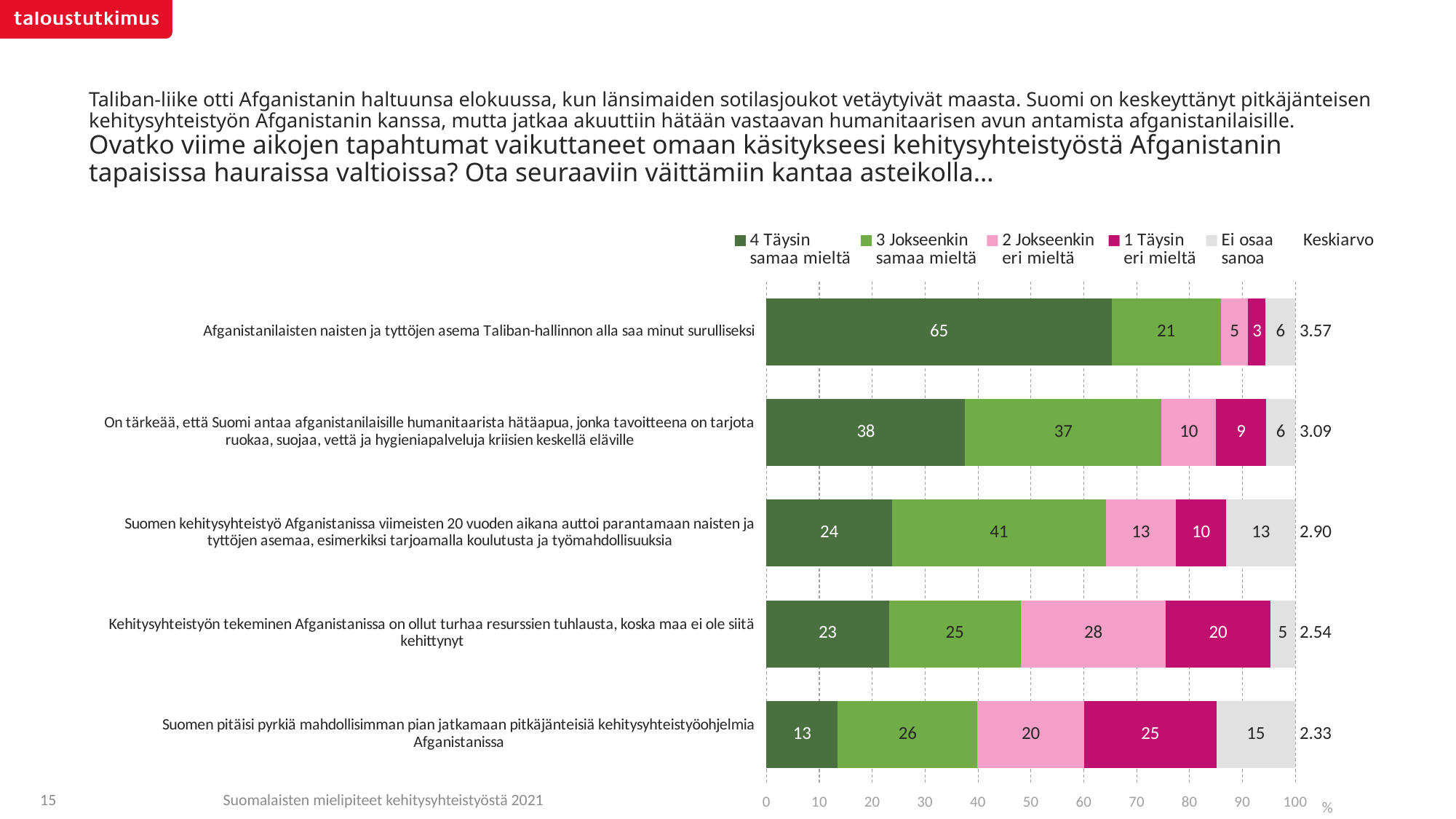
Which series is shown in dark green in the chart? 4 Täysin samaa mieltä What is the Keskiarvo value for the statement 'Suomen pitäisi pyrkiä mahdollisimman pian jatkamaan pitkäjänteisiä kehitysyhteistyöohjelmia Afganistanissa'? 2.33 What percentage answered '1 Täysin eri mieltä' to the statement 'Kehitysyhteistyön tekeminen Afganistanissa on ollut turhaa resurssien tuhlausta, koska maa ei ole siitä kehittynyt'? 20 How many series does the legend list? 5 How many statements (categories) are plotted in the chart? 5 Which is larger: the 'Ei osaa sanoa' share for 'Suomen kehitysyhteistyö Afganistanissa viimeisten 20 vuoden aikana auttoi...' or for 'Suomen pitäisi pyrkiä mahdollisimman pian jatkamaan...'? Suomen pitäisi pyrkiä mahdollisimman pian jatkamaan pitkäjänteisiä kehitysyhteistyöohjelmia Afganistanissa What is the difference between the '3 Jokseenkin samaa mieltä' share for 'Suomen kehitysyhteistyö Afganistanissa viimeisten 20 vuoden aikana auttoi parantamaan naisten ja tyttöjen asemaa...' and for 'Afganistanilaisten naisten ja tyttöjen asema Taliban-hallinnon alla saa minut surulliseksi'? 20 What kind of chart is shown on the slide? stacked bar chart Which statement has the highest Keskiarvo value? Afganistanilaisten naisten ja tyttöjen asema Taliban-hallinnon alla saa minut surulliseksi What is the combined share of '4 Täysin samaa mieltä' and '3 Jokseenkin samaa mieltä' for the statement 'On tärkeää, että Suomi antaa afganistanilaisille humanitaarista hätäapua...'? 75 What percentage of respondents answered '4 Täysin samaa mieltä' to the statement 'Afganistanilaisten naisten ja tyttöjen asema Taliban-hallinnon alla saa minut surulliseksi'? 65 Which statement has the lowest '4 Täysin samaa mieltä' share? Suomen pitäisi pyrkiä mahdollisimman pian jatkamaan pitkäjänteisiä kehitysyhteistyöohjelmia Afganistanissa